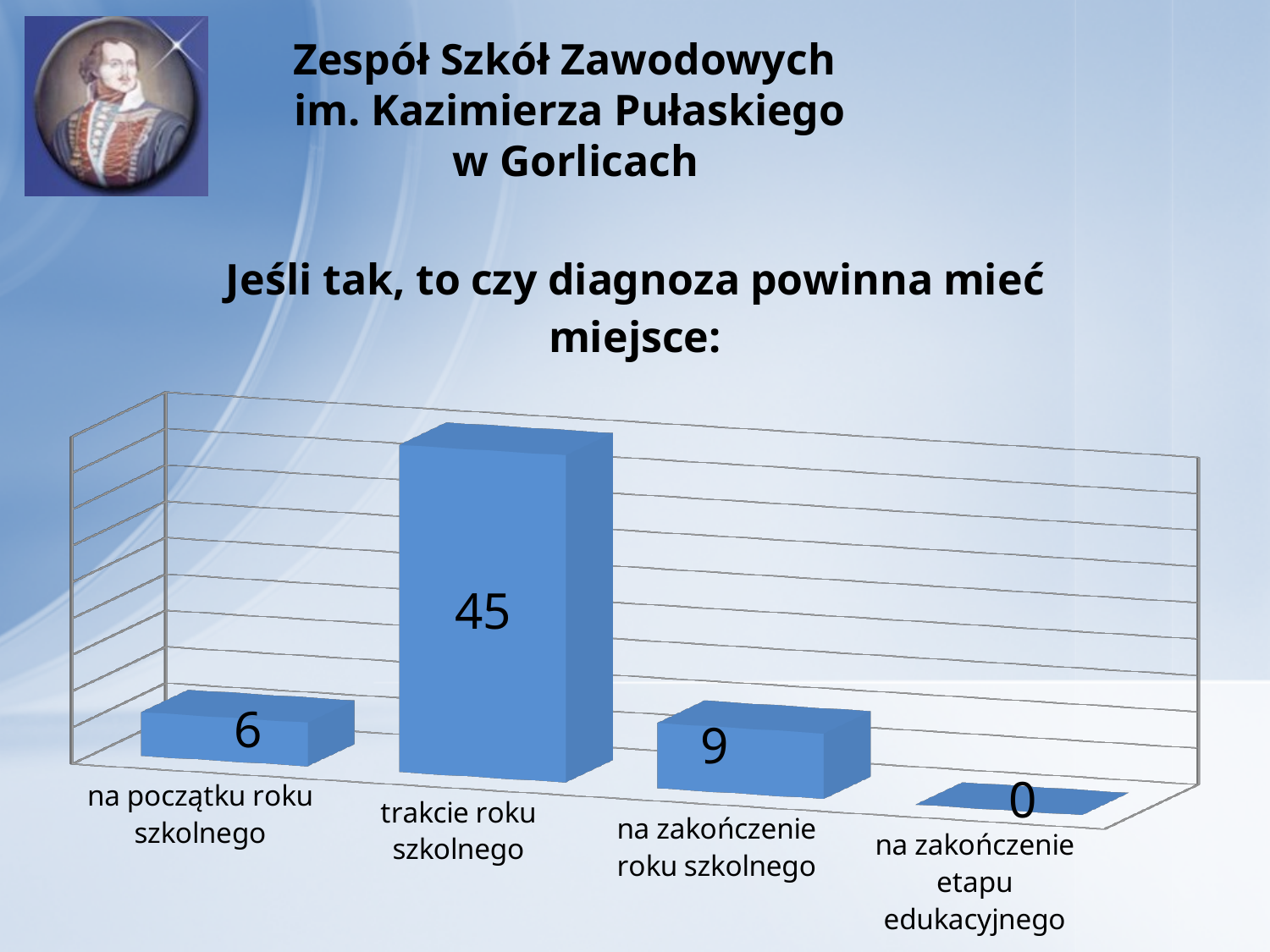
Which category has the highest value? trakcie roku szkolnego What is the value for "trakcie roku szkolnego"? 45 What is the value for "na początku roku szkolnego"? 6 What is the title of the chart? Jeśli tak, to czy diagnoza powinna mieć miejsce: Which category has the lowest value? na zakończenie etapu edukacyjnego Which is larger: the value for "na zakończenie roku szkolnego" or the value for "na początku roku szkolnego"? na zakończenie roku szkolnego What is the difference between the values for "trakcie roku szkolnego" and "na zakończenie roku szkolnego"? 36 What is the value for "na zakończenie etapu edukacyjnego"? 0 What is the difference between the values for "na zakończenie roku szkolnego" and "na początku roku szkolnego"? 3 What is the value for "na zakończenie roku szkolnego"? 9 How many categories are shown in the chart? 4 What kind of chart is shown on the slide? bar chart